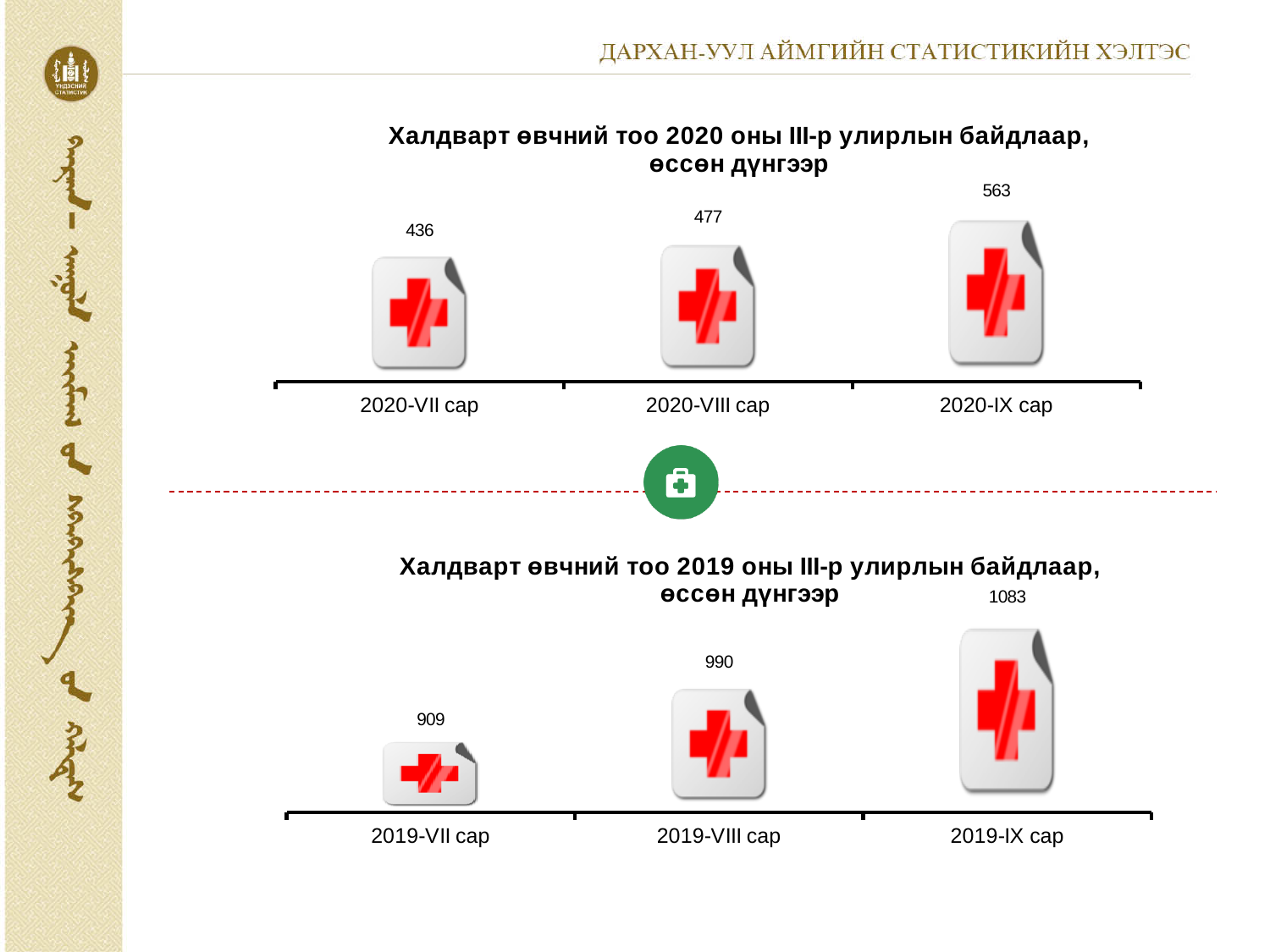
In the top chart (2020), what is the difference between the values for 2020-IX сар and 2020-VII сар? 127 What is the title of the bottom chart? Халдварт өвчний тоо 2019 оны III-р улирлын байдлаар, өссөн дүнгээр Do the values in the top chart (2020) rise or fall from 2020-VII сар to 2020-IX сар? rise In the bottom chart (2019), what is the difference between the values for 2019-IX сар and 2019-VIII сар? 93 How many categories are shown in the bottom chart (2019)? 3 In the bottom chart (2019), which month has the lowest value? 2019-VII сар In the top chart (2020), what is the value for 2020-VII сар? 436 In the bottom chart (2019), what is the value for 2019-IX сар? 1083 In the top chart (2020), which is larger: the value for 2020-VIII сар or 2020-VII сар? 2020-VIII сар In the top chart (2020), what is the value for 2020-IX сар? 563 In the top chart (2020), which month has the highest value? 2020-IX сар In the bottom chart (2019), what is the value for 2019-VIII сар? 990